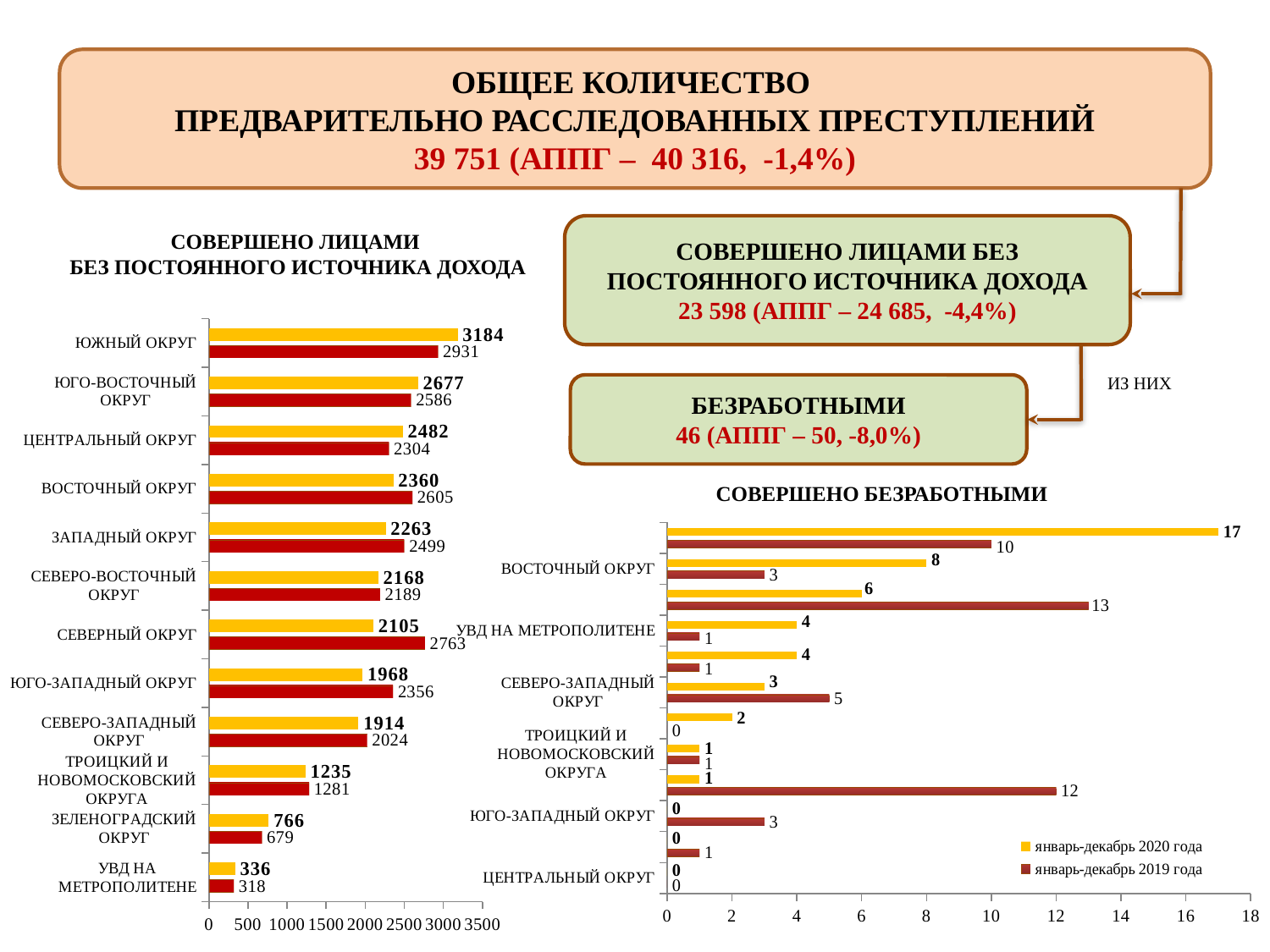
What are the two legend entries in the chart 'СОВЕРШЕНО БЕЗРАБОТНЫМИ'? январь-декабрь 2020 года and январь-декабрь 2019 года In the chart 'СОВЕРШЕНО ЛИЦАМИ БЕЗ ПОСТОЯННОГО ИСТОЧНИКА ДОХОДА', what is the 2019 (red) value for ЗЕЛЕНОГРАДСКИЙ ОКРУГ? 679 What is the highest value shown in the chart 'СОВЕРШЕНО БЕЗРАБОТНЫМИ'? 17 How many series does the legend of the chart 'СОВЕРШЕНО БЕЗРАБОТНЫМИ' list? 2 In the chart 'СОВЕРШЕНО ЛИЦАМИ БЕЗ ПОСТОЯННОГО ИСТОЧНИКА ДОХОДА', for СЕВЕРНЫЙ ОКРУГ, which is larger: the 2020 value or the 2019 value? 2019 value (2763) In the chart 'СОВЕРШЕНО ЛИЦАМИ БЕЗ ПОСТОЯННОГО ИСТОЧНИКА ДОХОДА', what is the difference between the 2020 and 2019 values for ЮЖНЫЙ ОКРУГ? 253 What kind of chart is 'СОВЕРШЕНО ЛИЦАМИ БЕЗ ПОСТОЯННОГО ИСТОЧНИКА ДОХОДА'? Bar chart In the chart 'СОВЕРШЕНО ЛИЦАМИ БЕЗ ПОСТОЯННОГО ИСТОЧНИКА ДОХОДА', which category has the highest 2020 (yellow) value? ЮЖНЫЙ ОКРУГ In the chart 'СОВЕРШЕНО ЛИЦАМИ БЕЗ ПОСТОЯННОГО ИСТОЧНИКА ДОХОДА', what is the 2020 (yellow) value for ЮЖНЫЙ ОКРУГ? 3184 In the chart 'СОВЕРШЕНО ЛИЦАМИ БЕЗ ПОСТОЯННОГО ИСТОЧНИКА ДОХОДА', which category has the lowest 2020 (yellow) value? УВД НА МЕТРОПОЛИТЕНЕ How many categories are shown in the chart 'СОВЕРШЕНО ЛИЦАМИ БЕЗ ПОСТОЯННОГО ИСТОЧНИКА ДОХОДА'? 12 In the chart 'СОВЕРШЕНО ЛИЦАМИ БЕЗ ПОСТОЯННОГО ИСТОЧНИКА ДОХОДА', what is the 2020 (yellow) value for ТРОИЦКИЙ И НОВОМОСКОВСКИЙ ОКРУГА? 1235